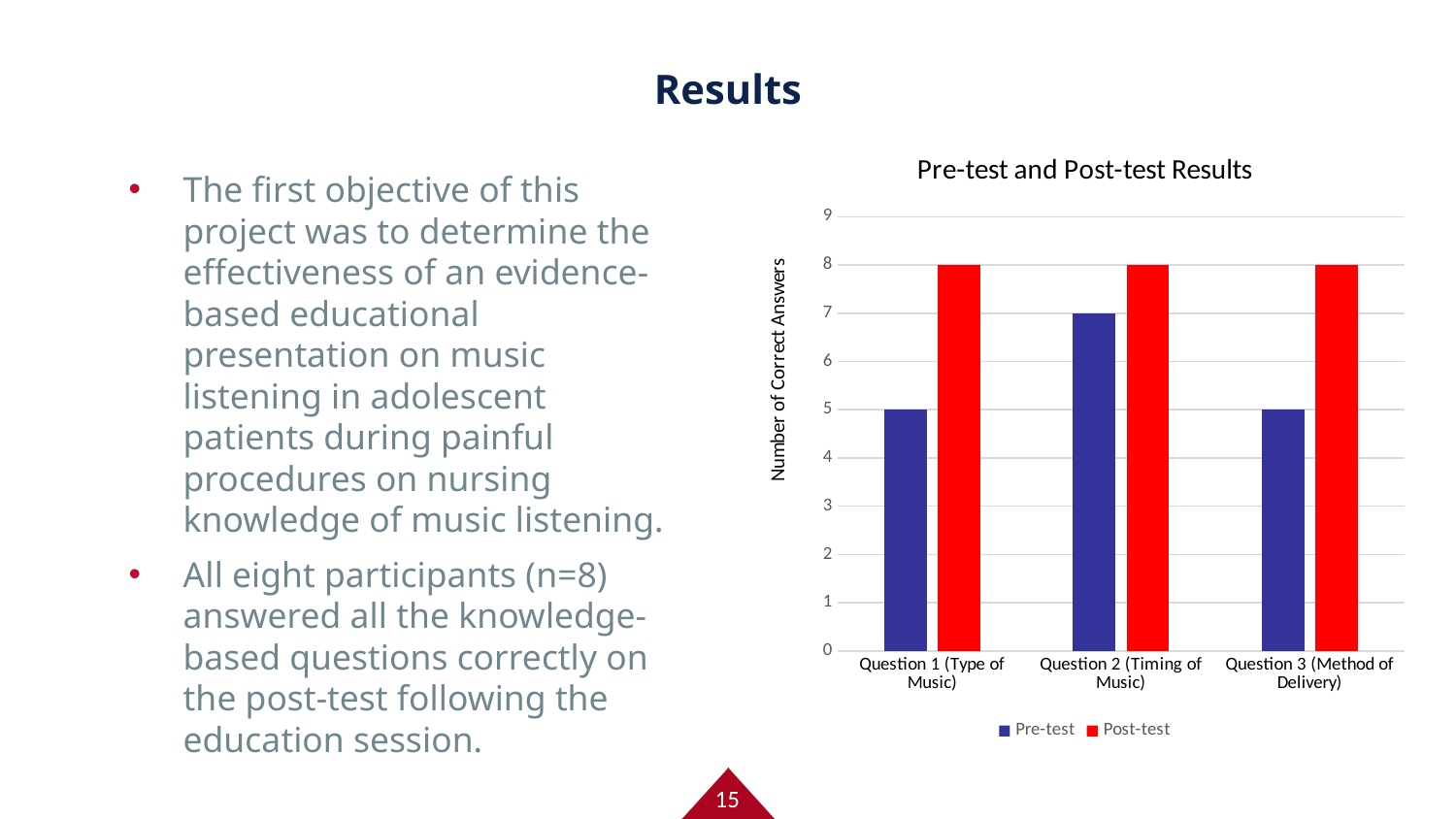
What type of chart is shown on the slide? bar chart Is the Pre-test value for Question 2 (Timing of Music) greater or less than 6? greater How many series does the chart legend list? 2 Which is larger for Question 3 (Method of Delivery), the Pre-test value or the Post-test value? Post-test What is the Post-test value for Question 3 (Method of Delivery)? 8 What is the difference between the Post-test and Pre-test values for Question 1 (Type of Music)? 3 Which question has the highest Pre-test value? Question 2 (Timing of Music) How many question categories are shown on the x axis of the chart? 3 What is the title of the chart? Pre-test and Post-test Results What is the label of the vertical axis of the chart? Number of Correct Answers What is the Pre-test value for Question 2 (Timing of Music)? 7 What is the Pre-test value for Question 1 (Type of Music)? 5